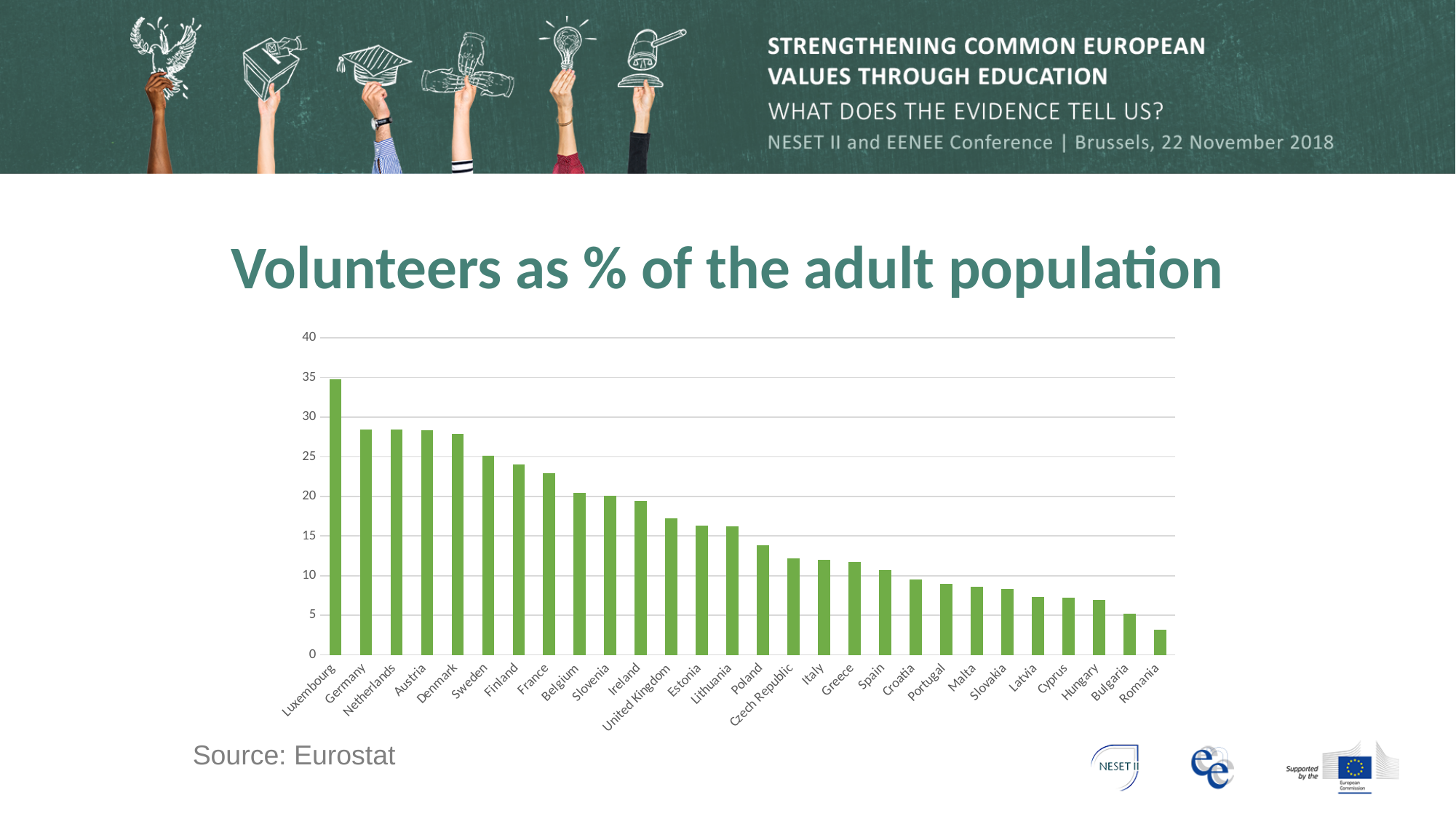
What is the title of the chart? Volunteers as % of the adult population Do the values rise or fall moving from left to right along the x axis? fall Which country has the highest share of volunteers in the adult population? Luxembourg Which has a higher value, France or Poland? France Is the value for Romania greater or less than 5? less Is the value for Luxembourg greater or less than 30? greater Which country has the lowest share of volunteers in the adult population? Romania What kind of chart is shown on the slide? bar chart How many countries are shown on the chart? 28 Is the value for United Kingdom greater or less than 15? greater